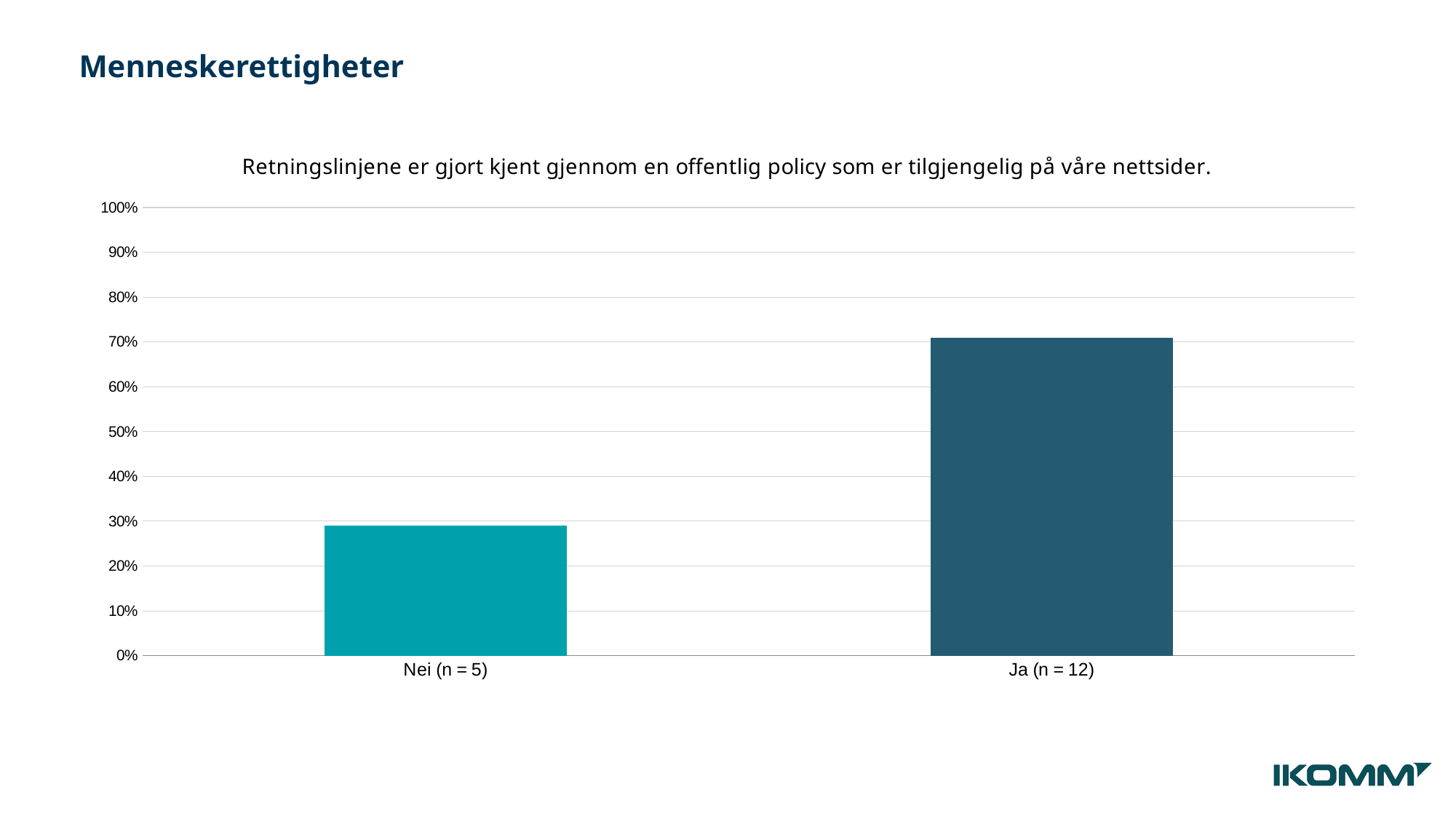
How many categories are shown on the x axis of the chart? 2 How many respondents (n) are in the Nei category according to the axis label? 5 Which bar is taller, Nei (n = 5) or Ja (n = 12)? Ja (n = 12) What kind of chart is shown on the slide? bar chart How many respondents (n) are in the Ja category according to the axis label? 12 What is the title of the chart? Retningslinjene er gjort kjent gjennom en offentlig policy som er tilgjengelig på våre nettsider. Which category has the lowest bar in the chart? Nei (n = 5) Which category has the highest bar in the chart? Ja (n = 12) Is the value for Ja (n = 12) greater or less than 60%? greater Is the value for Nei (n = 5) greater or less than 20%? greater Is the value for Ja (n = 12) greater or less than 80%? less